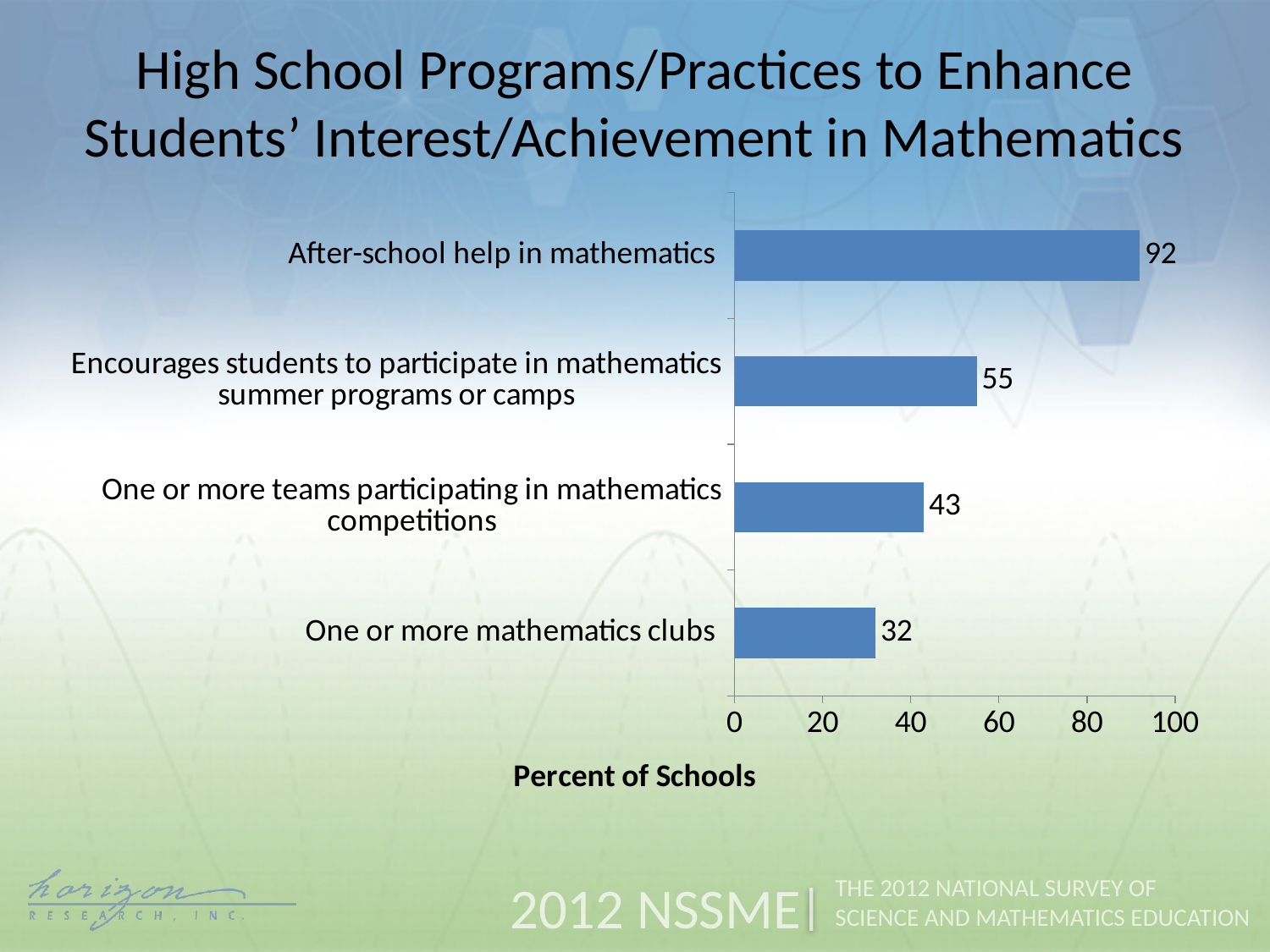
What percent of schools have one or more teams participating in mathematics competitions? 43 What is the value for 'One or more mathematics clubs'? 32 Is the value for 'One or more teams participating in mathematics competitions' greater or less than 60? less Which program/practice has the lowest percent of schools? One or more mathematics clubs What is the value for 'Encourages students to participate in mathematics summer programs or camps'? 55 Which is larger: the value for mathematics summer programs or camps, or the value for teams participating in mathematics competitions? Encourages students to participate in mathematics summer programs or camps Which program/practice has the highest percent of schools? After-school help in mathematics What percent of schools offer after-school help in mathematics? 92 What is the difference between the values for after-school help in mathematics and one or more mathematics clubs? 60 How many programs/practices are shown in the chart? 4 What kind of chart is shown on the slide? Bar chart What is the label of the horizontal axis? Percent of Schools